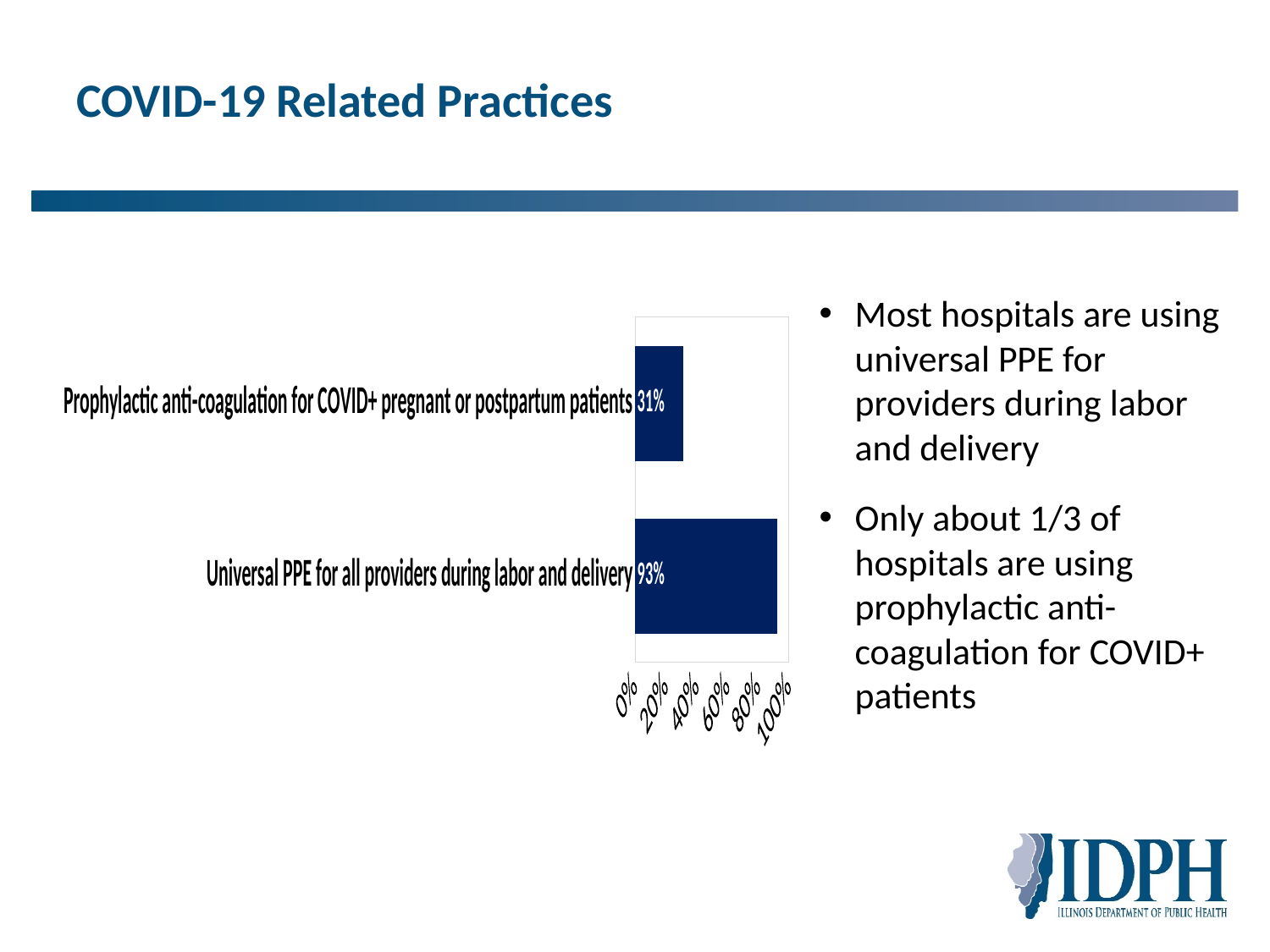
What percentage of hospitals use prophylactic anti-coagulation for COVID+ pregnant or postpartum patients? 31% What percentage of hospitals use universal PPE for all providers during labor and delivery? 93% What is the maximum value shown on the chart's axis? 100% Is the value for prophylactic anti-coagulation for COVID+ pregnant or postpartum patients greater or less than 40%? less Which is larger: the value for universal PPE for all providers during labor and delivery or the value for prophylactic anti-coagulation for COVID+ pregnant or postpartum patients? Universal PPE for all providers during labor and delivery What kind of chart is shown on the slide? Bar chart Which practice has the highest value in the chart? Universal PPE for all providers during labor and delivery Which practice has the lowest value in the chart? Prophylactic anti-coagulation for COVID+ pregnant or postpartum patients Is the value for universal PPE for all providers during labor and delivery greater or less than 80%? greater How many practices are shown in the chart? 2 What is the difference in percentage points between universal PPE for all providers during labor and delivery and prophylactic anti-coagulation for COVID+ pregnant or postpartum patients? 62 percentage points What is the title of the slide containing the chart? COVID-19 Related Practices